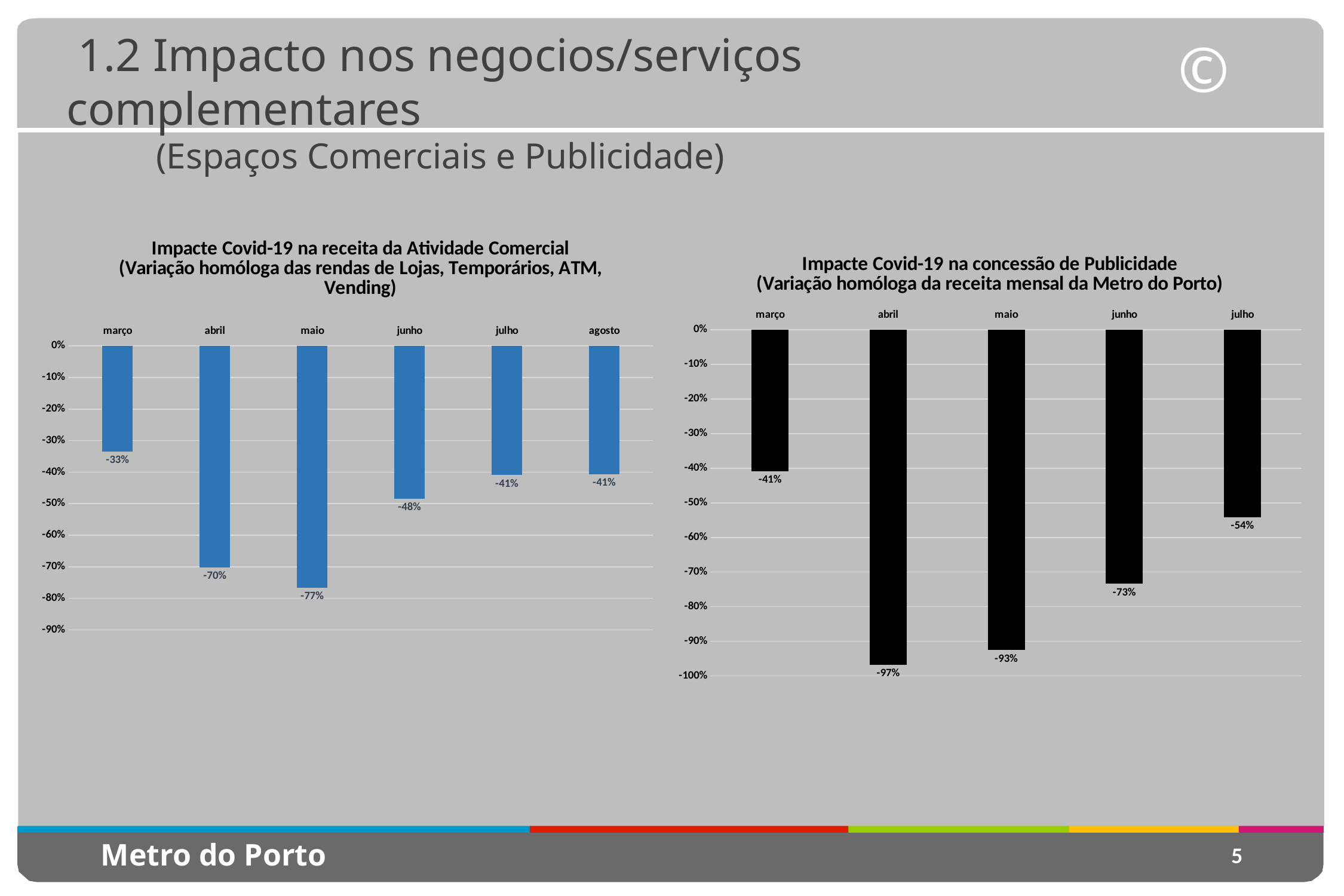
In the left chart (Impacte Covid-19 na receita da Atividade Comercial), what is the value for abril? -70% In the left chart (Impacte Covid-19 na receita da Atividade Comercial), which is larger, the value for março or the value for abril? março In the left chart (Impacte Covid-19 na receita da Atividade Comercial), what is the difference between the values for maio and junho? 29 percentage points How many months are shown in the left chart (Impacte Covid-19 na receita da Atividade Comercial)? 6 In the left chart (Impacte Covid-19 na receita da Atividade Comercial), what is the value for março? -33% What type of chart is the right chart (Impacte Covid-19 na concessão de Publicidade)? Bar chart In the right chart (Impacte Covid-19 na concessão de Publicidade), what is the value for junho? -73% In the right chart (Impacte Covid-19 na concessão de Publicidade), which month has the highest value (smallest decline)? março In the right chart (Impacte Covid-19 na concessão de Publicidade), what is the difference between the values for abril and julho? 43 percentage points In the left chart (Impacte Covid-19 na receita da Atividade Comercial), which month has the lowest value (largest decline)? maio In the right chart (Impacte Covid-19 na concessão de Publicidade), which month has the lowest value (largest decline)? abril In the right chart (Impacte Covid-19 na concessão de Publicidade), what is the value for julho? -54%